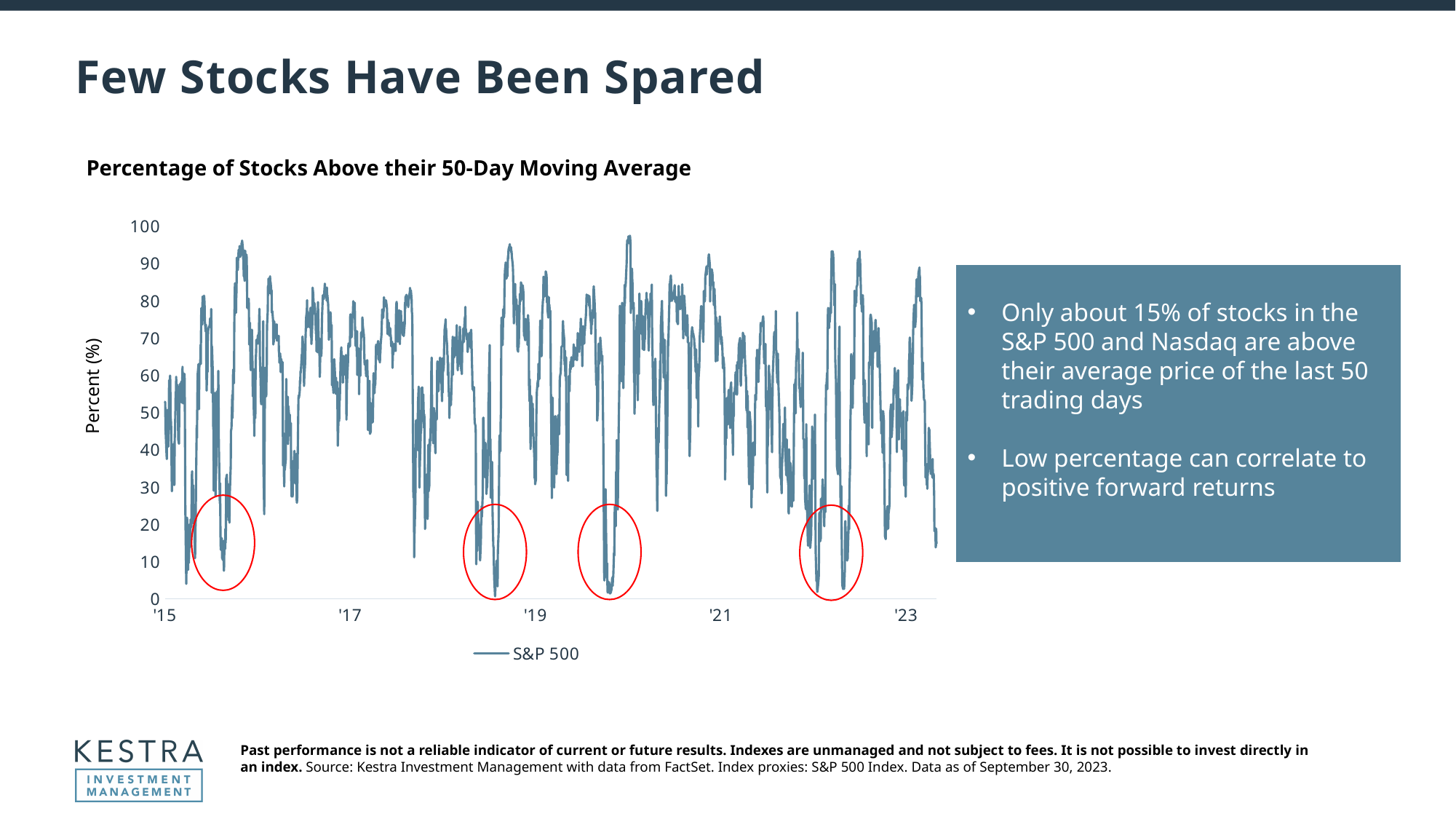
What is the label on the vertical axis of the chart? Percent (%) What kind of chart is shown on the slide? line chart What is the first year label shown on the horizontal axis? '15 What is the title of the chart? Percentage of Stocks Above their 50-Day Moving Average Is the final value of the S&P 500 line at the right end of the chart greater or less than 30? less How many red circles are drawn on the chart to highlight low points? 4 What series name is shown in the chart legend? S&P 500 What is the last year label shown on the horizontal axis? '23 How many series does the chart legend list? 1 Is the highest value reached by the S&P 500 line greater or less than 90? greater Is the lowest value reached by the S&P 500 line greater or less than 10? less What is the maximum value shown on the vertical axis of the chart? 100